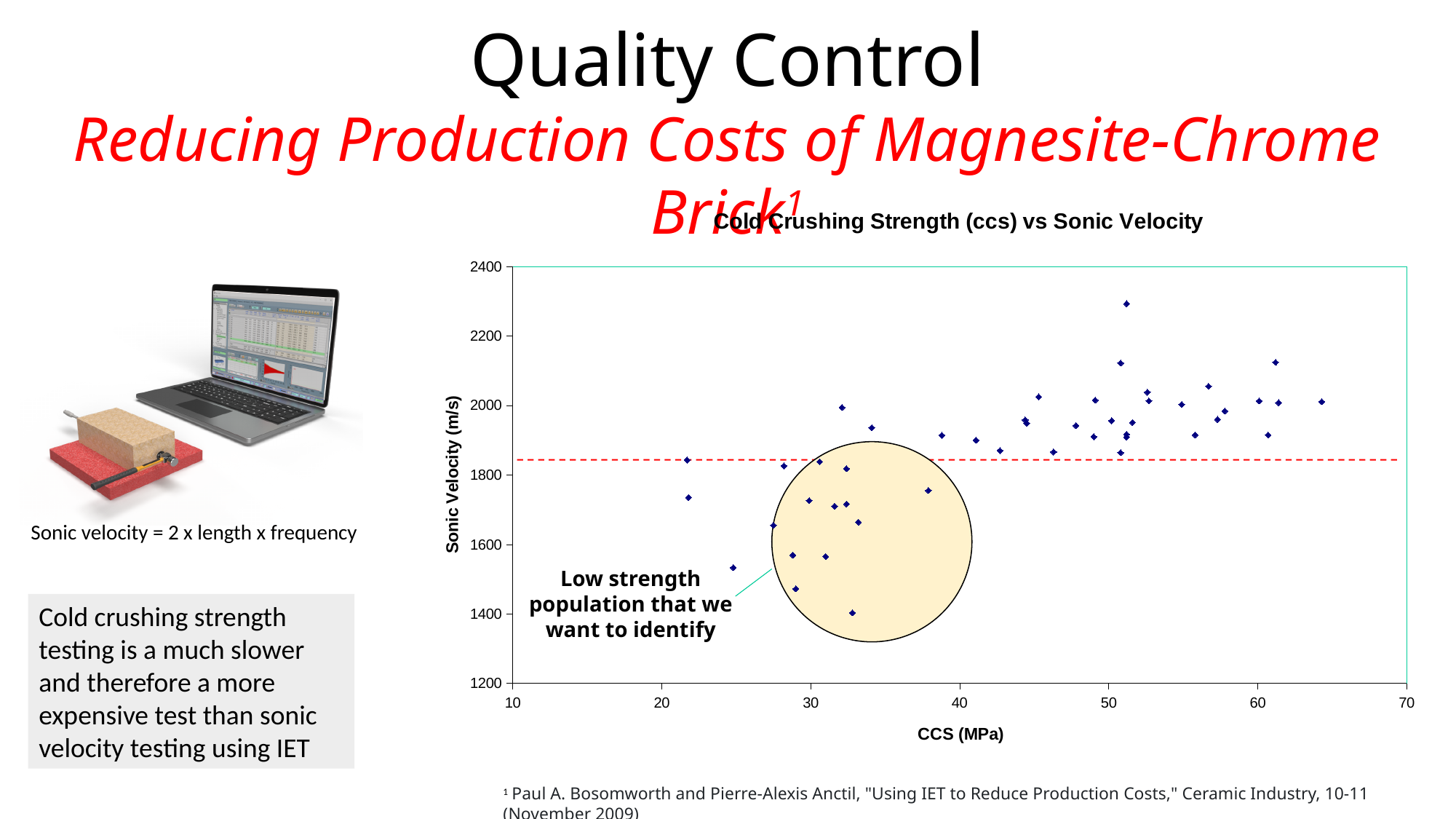
What is the title of the chart? Cold Crushing Strength (ccs) vs Sonic Velocity What is the label of the x axis of the chart? CCS (MPa) What is the minimum value shown on the x axis of the chart? 10 Are the points inside the circled 'low strength population' mostly above or below 1800 m/s? below Is the highest sonic velocity value plotted on the chart greater or less than 2200 m/s? greater Is the lowest sonic velocity value plotted on the chart greater or less than 1600 m/s? less What kind of chart is shown on the slide? scatter chart Does sonic velocity generally rise or fall as CCS increases along the x axis? rise